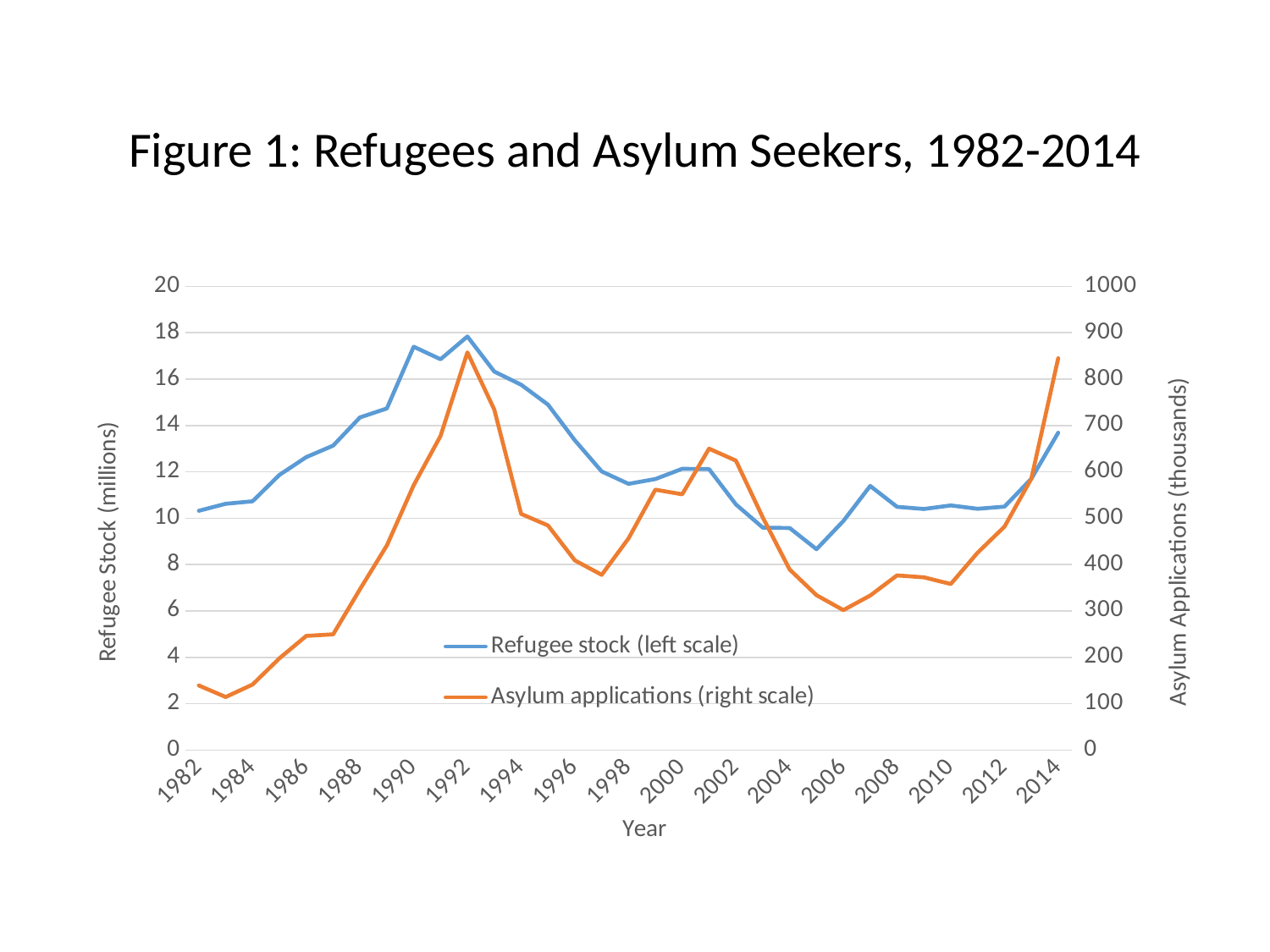
What is the title of the chart? Figure 1: Refugees and Asylum Seekers, 1982-2014 Which is larger for Asylum applications: the value in 2001 or the value in 2006? 2001 Is the Asylum applications value for 2014 greater or less than 800? greater In which year does the Refugee stock series reach its lowest value? 2005 What is the label of the right-hand vertical axis? Asylum Applications (thousands) In which year does the Asylum applications series reach its lowest value? 1983 Is the Asylum applications value for 2006 greater or less than 400? less In which year does the Refugee stock series reach its highest value? 1992 Is the Refugee stock value for 2005 greater or less than 10? less How many series does the legend list? 2 What kind of chart is shown on the slide? Line chart